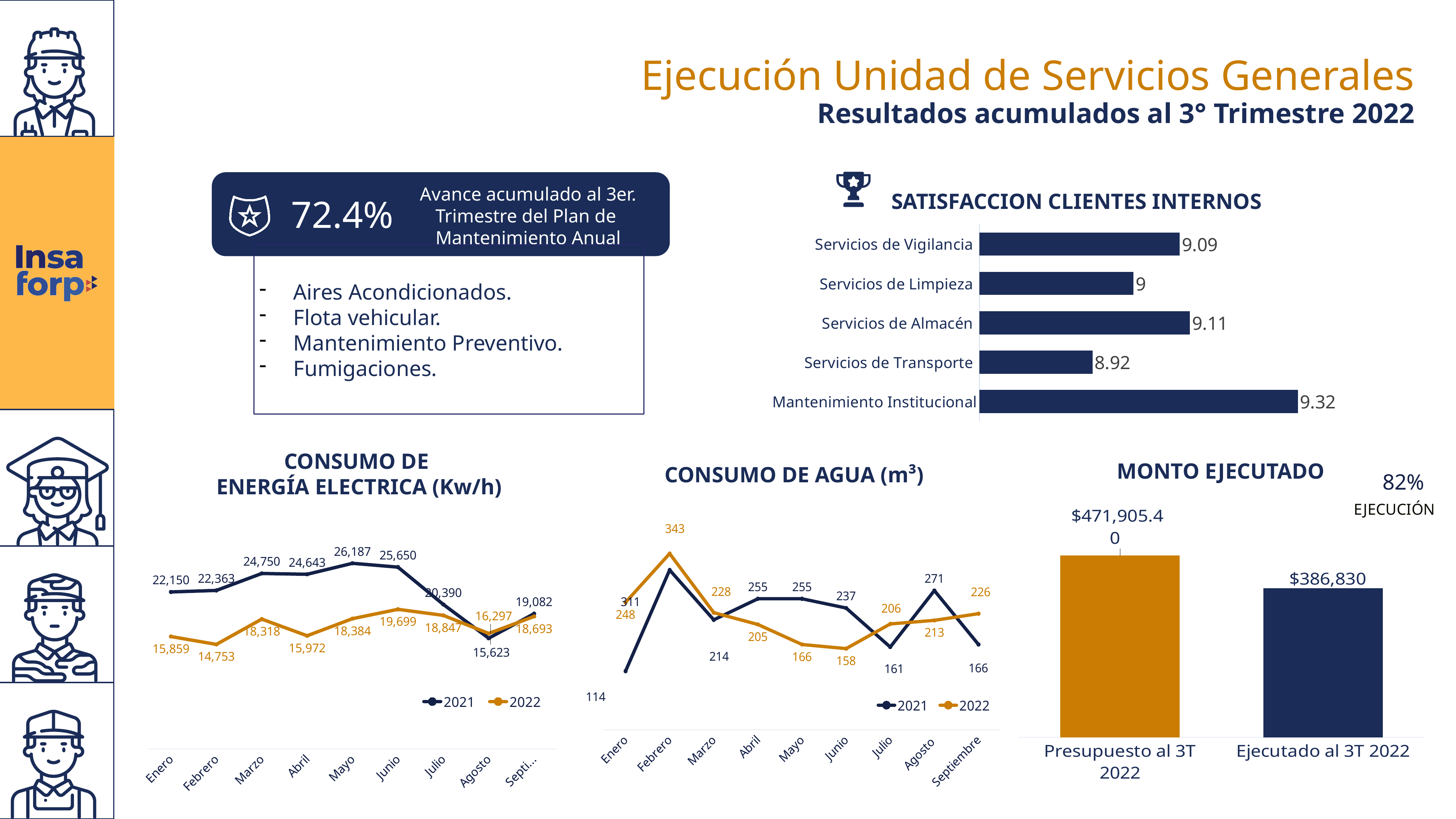
What kind of chart is the MONTO EJECUTADO chart? bar chart In the CONSUMO DE AGUA (m³) chart, which is larger in Junio: the 2021 value or the 2022 value? 2021 In the CONSUMO DE AGUA (m³) chart, which month has the highest 2022 value? Febrero In the CONSUMO DE ENERGÍA ELECTRICA (Kw/h) chart, what is the difference between the 2021 and 2022 values for Enero? 6,291 In the MONTO EJECUTADO chart, what is the value for Ejecutado al 3T 2022? $386,830 In the SATISFACCION CLIENTES INTERNOS chart, which category has the highest value? Mantenimiento Institucional How many categories are shown in the SATISFACCION CLIENTES INTERNOS chart? 5 In the SATISFACCION CLIENTES INTERNOS chart, which category has the lowest value? Servicios de Transporte In the CONSUMO DE AGUA (m³) chart, what is the 2021 value for Agosto? 271 How many series does the legend of the CONSUMO DE ENERGÍA ELECTRICA (Kw/h) chart list? 2 In the SATISFACCION CLIENTES INTERNOS chart, what is the value for Servicios de Transporte? 8.92 In the CONSUMO DE ENERGÍA ELECTRICA (Kw/h) chart, what is the 2021 value for Mayo? 26,187